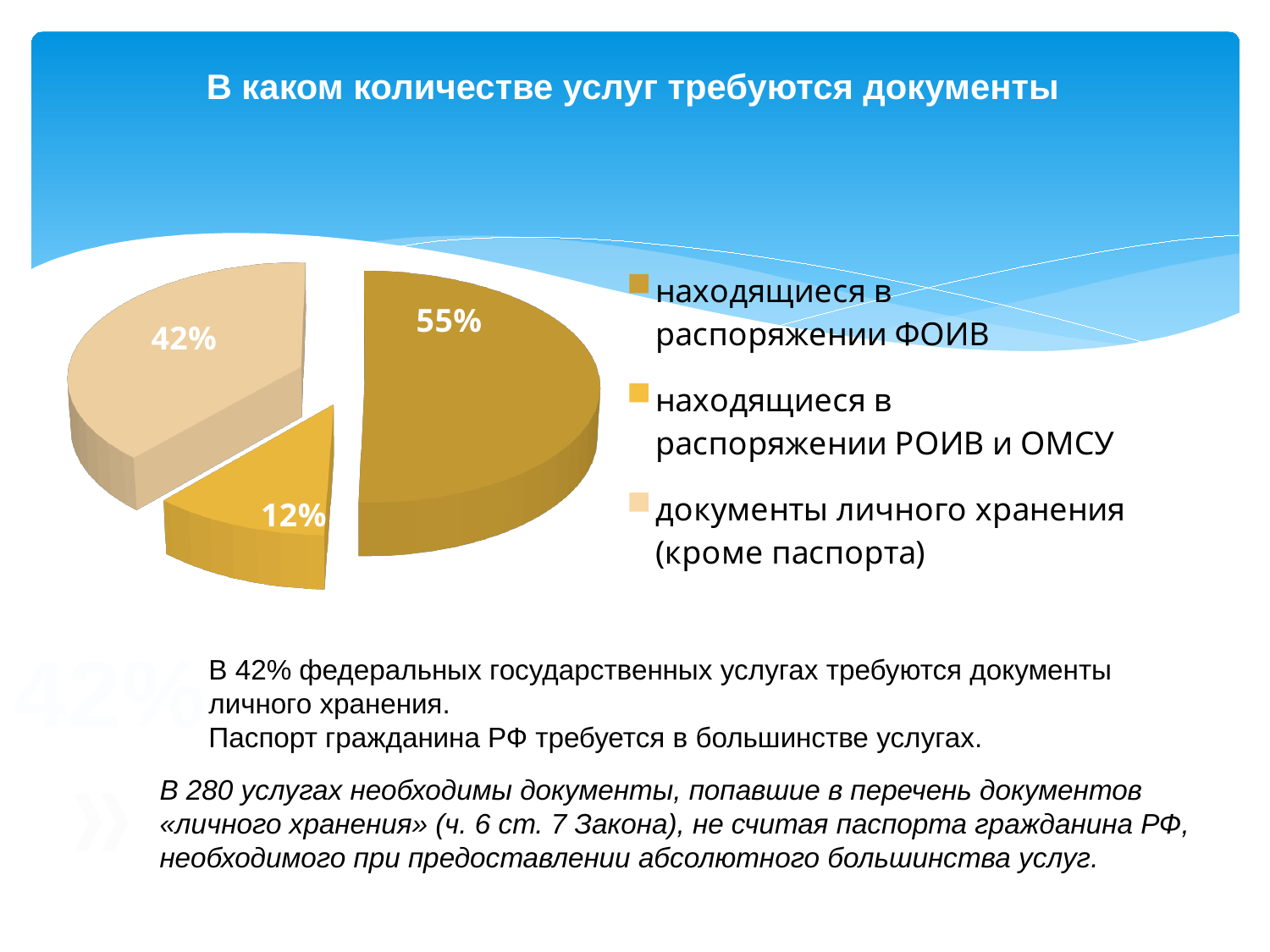
What is the difference between the values for "документы личного хранения (кроме паспорта)" and "находящиеся в распоряжении РОИВ и ОМСУ"? 30% What kind of chart is shown on the slide? Pie chart Which is larger: the slice for "находящиеся в распоряжении ФОИВ" or the slice for "документы личного хранения (кроме паспорта)"? находящиеся в распоряжении ФОИВ What is the value for "находящиеся в распоряжении РОИВ и ОМСУ"? 12% Which category has the largest slice of the pie? находящиеся в распоряжении ФОИВ What is the title of the chart? В каком количестве услуг требуются документы What is the value for "находящиеся в распоряжении ФОИВ"? 55% What is the value for "документы личного хранения (кроме паспорта)"? 42% How many slices does the pie chart have? 3 Which category has the smallest slice of the pie? находящиеся в распоряжении РОИВ и ОМСУ What is the difference between the values for "находящиеся в распоряжении ФОИВ" and "документы личного хранения (кроме паспорта)"? 13% Which legend entry is shown in the lightest colour? документы личного хранения (кроме паспорта)